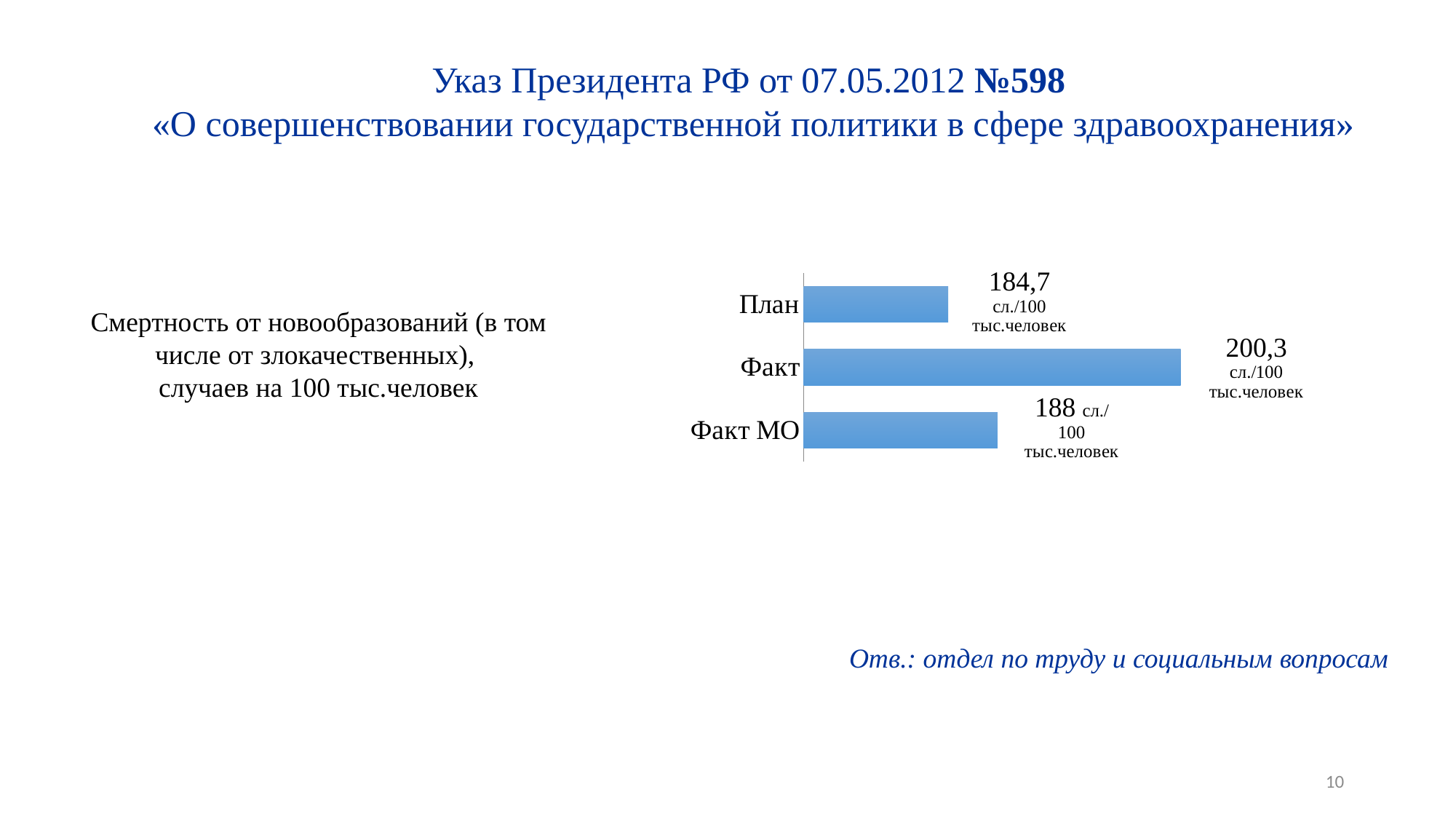
What is the value for Факт МО? 188 How many categories are shown in the chart? 3 What is the value for Факт? 200,3 What is the difference between the values for Факт and План? 15,6 What kind of chart is shown on the slide? bar chart What indicator does the chart describe, according to the text to its left? Смертность от новообразований (в том числе от злокачественных), случаев на 100 тыс.человек Which category has the highest value? Факт Which category has the lowest value? План What is the value for План? 184,7 What unit is shown next to the data labels in the chart? сл./100 тыс.человек What is the difference between the values for Факт МО and План? 3,3 Which is larger, the value for Факт or the value for Факт МО? Факт